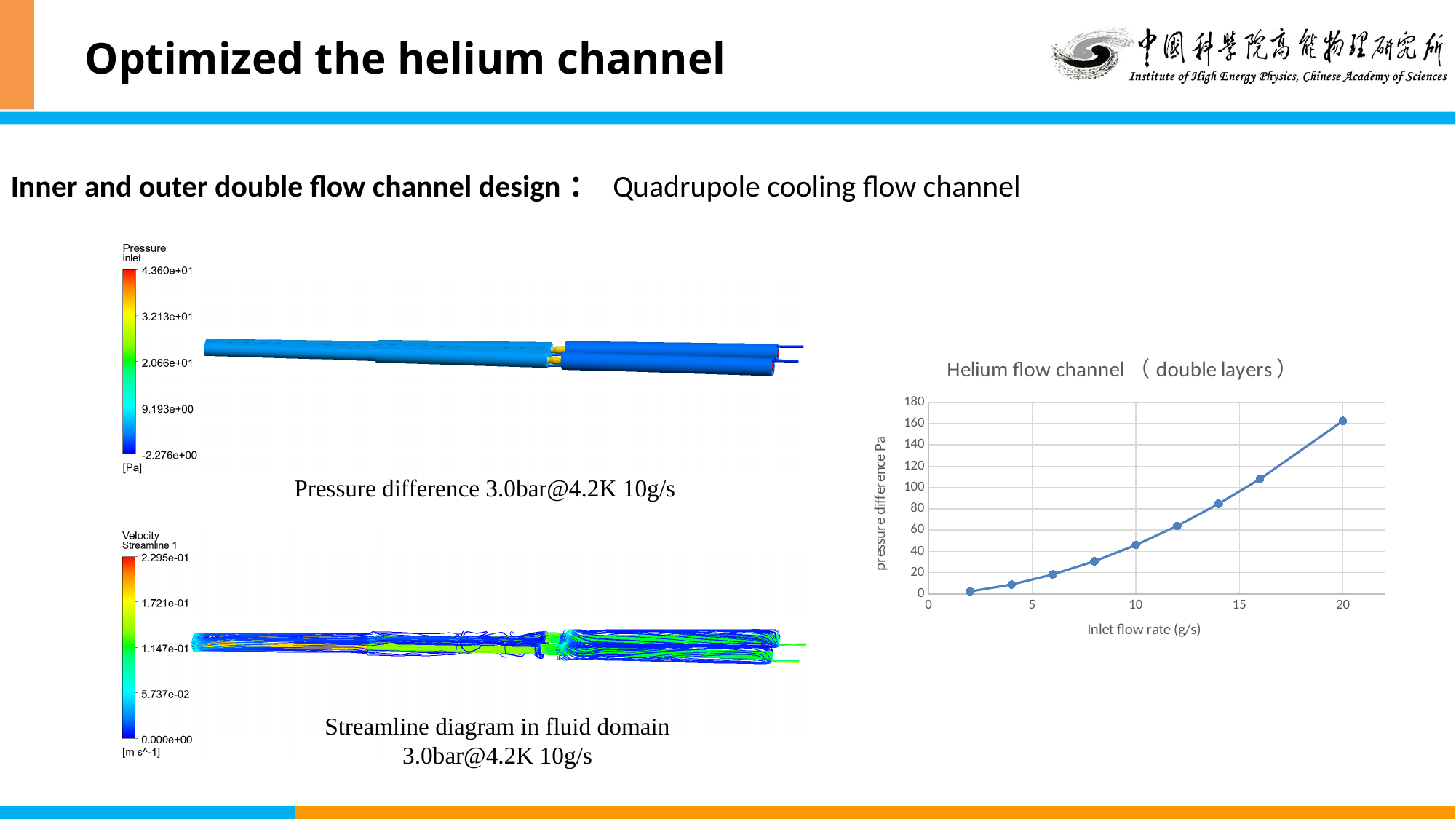
How many data points are plotted on the chart? 9 At which inlet flow rate is the pressure difference highest? 20 What is the title of the chart? Helium flow channel (double layers) Is the pressure difference at an inlet flow rate of 10 g/s greater or less than 60? less Is the pressure difference at an inlet flow rate of 2 g/s greater or less than 20? less Which has the larger pressure difference: an inlet flow rate of 8 g/s or 16 g/s? 16 g/s At which inlet flow rate is the pressure difference lowest? 2 Is the pressure difference at an inlet flow rate of 20 g/s greater or less than 140? greater Does the pressure difference rise or fall as the inlet flow rate increases? rises What is the label of the x axis of the chart? Inlet flow rate (g/s) What kind of chart is shown on the slide? line chart